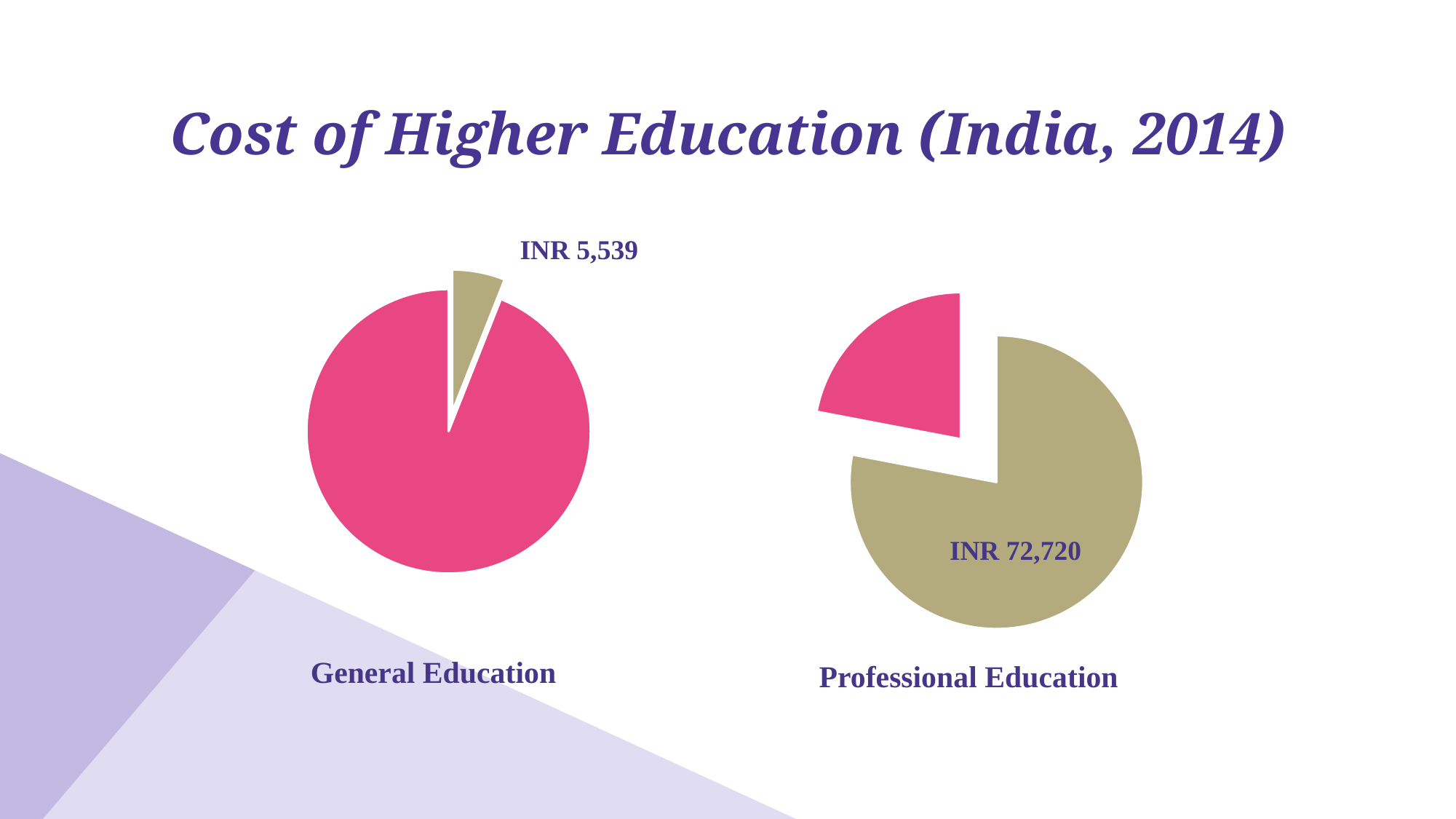
In the General Education pie chart, which slice is larger: the pink slice or the olive slice? The pink slice How many slices does the Professional Education pie chart have? 2 In the General Education pie chart, what colour is the slice labelled INR 5,539? Olive What is the title of the slide containing the two pie charts? Cost of Higher Education (India, 2014) What kind of chart is used for General Education? Pie chart What is the difference between the labelled value on the Professional Education chart and the labelled value on the General Education chart? INR 67,181 Which labelled value is larger: INR 5,539 on the General Education chart or INR 72,720 on the Professional Education chart? INR 72,720 (Professional Education) What kind of chart is used for Professional Education? Pie chart How many slices does the General Education pie chart have? 2 In the General Education pie chart, what value is printed on the labelled slice? INR 5,539 In the Professional Education pie chart, what value is printed on the labelled slice? INR 72,720 In the Professional Education pie chart, which slice is larger: the pink slice or the olive slice? The olive slice